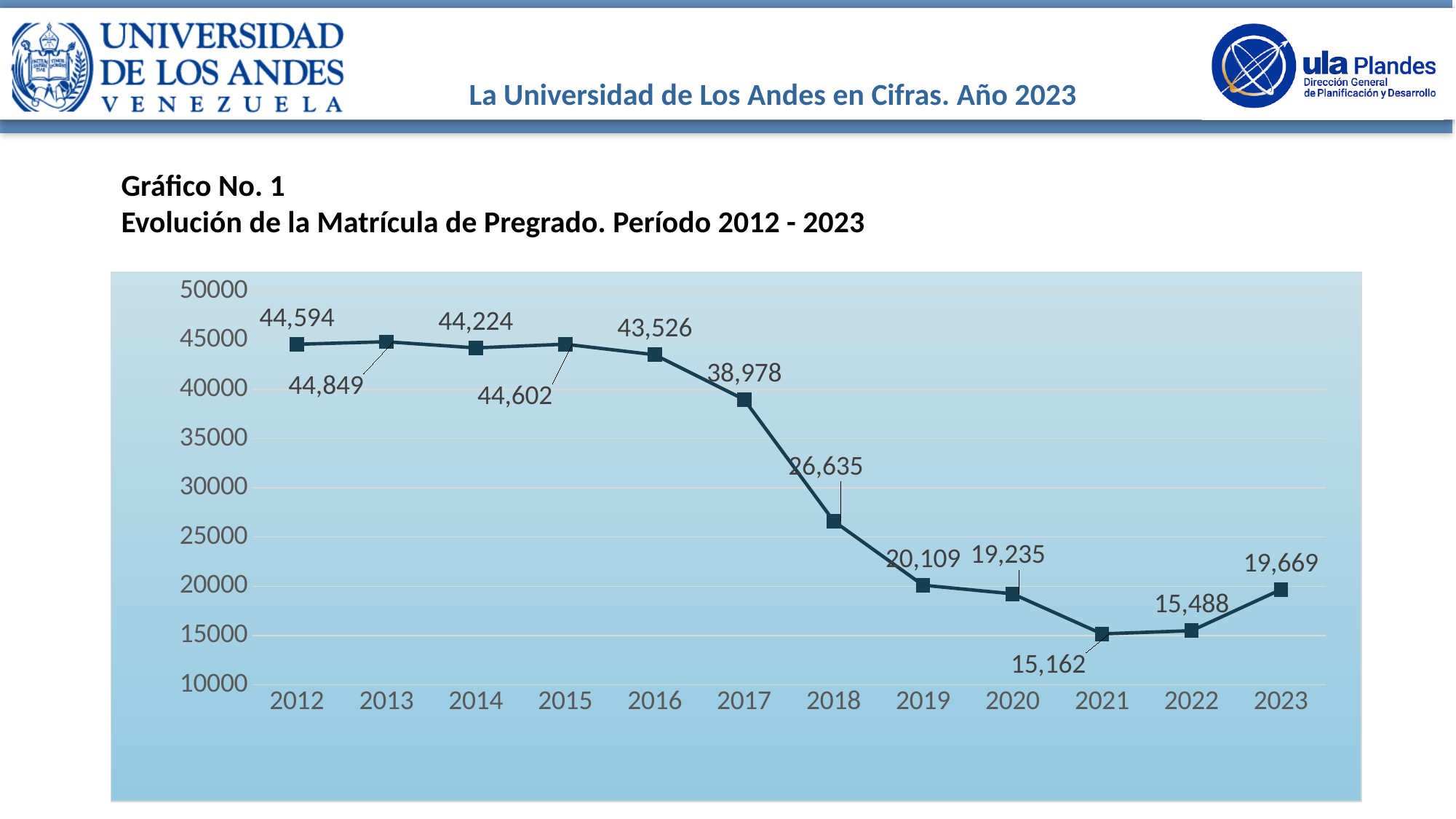
What was the undergraduate enrollment in 2018? 26,635 What is the difference between the 2012 value and the 2023 value? 24,925 What was the enrollment in 2012? 44,594 What is the overall trend of enrollment from 2012 to 2021? falling Which is larger, the value for 2019 or the value for 2020? 2019 By how much did enrollment fall from 2017 to 2018? 12,343 Is the value for 2017 greater or less than 35000? greater Which year has the highest enrollment? 2013 Which year has the lowest enrollment? 2021 What value is shown for 2023? 19,669 How many years are plotted on the chart? 12 What kind of chart is this? line chart